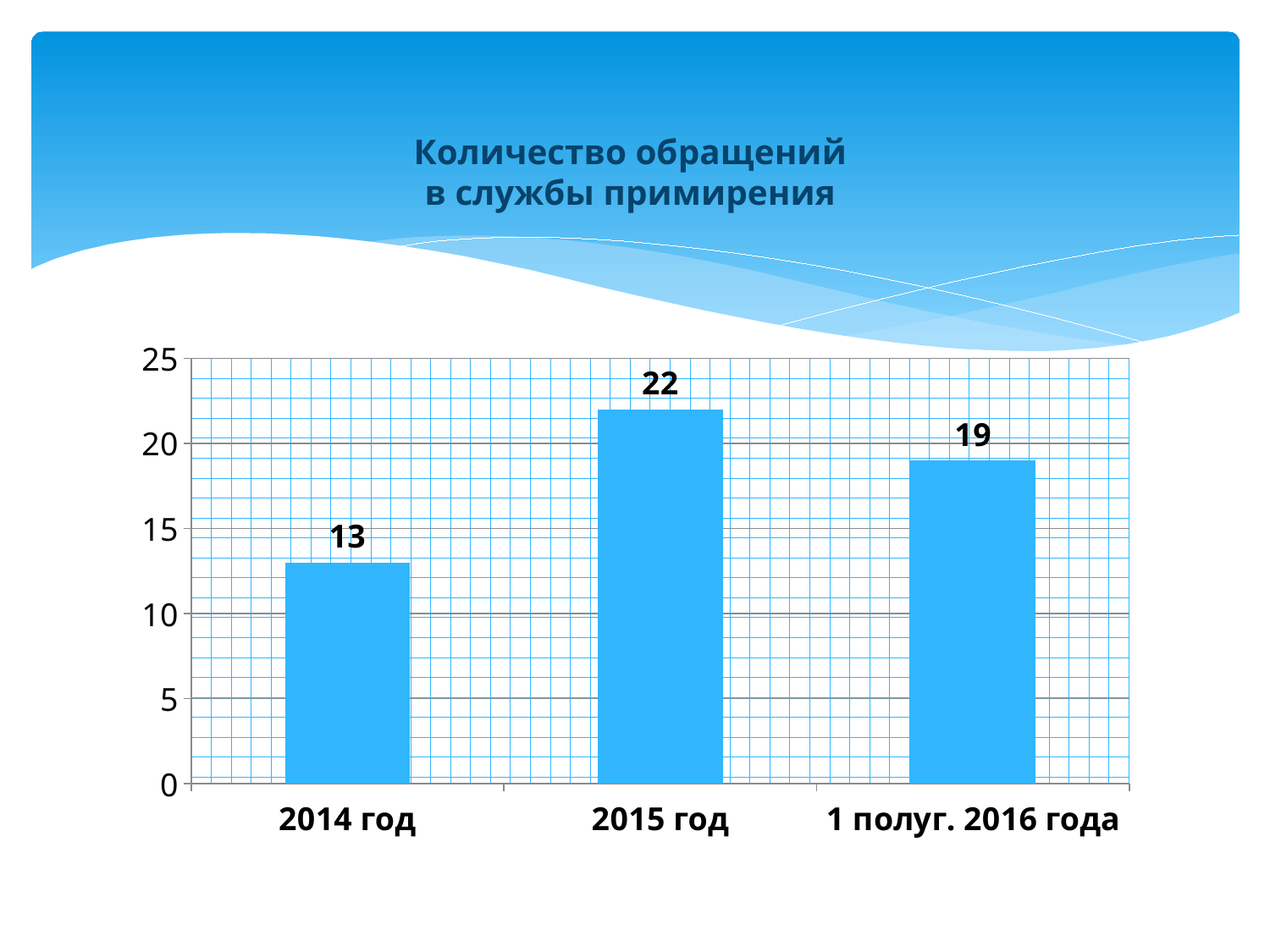
Is the value for 2015 год greater or less than 20? greater What kind of chart is shown on the slide? bar chart What is the title of the chart? Количество обращений в службы примирения What is the value for 1 полуг. 2016 года? 19 What is the value for 2014 год? 13 Which category has the highest value? 2015 год How many categories are shown on the x axis? 3 What is the value for 2015 год? 22 What is the difference between the values for 2015 год and 2014 год? 9 What is the difference between the values for 2015 год and 1 полуг. 2016 года? 3 Which category has the lowest value? 2014 год Which is larger, the value for 2014 год or the value for 1 полуг. 2016 года? 1 полуг. 2016 года